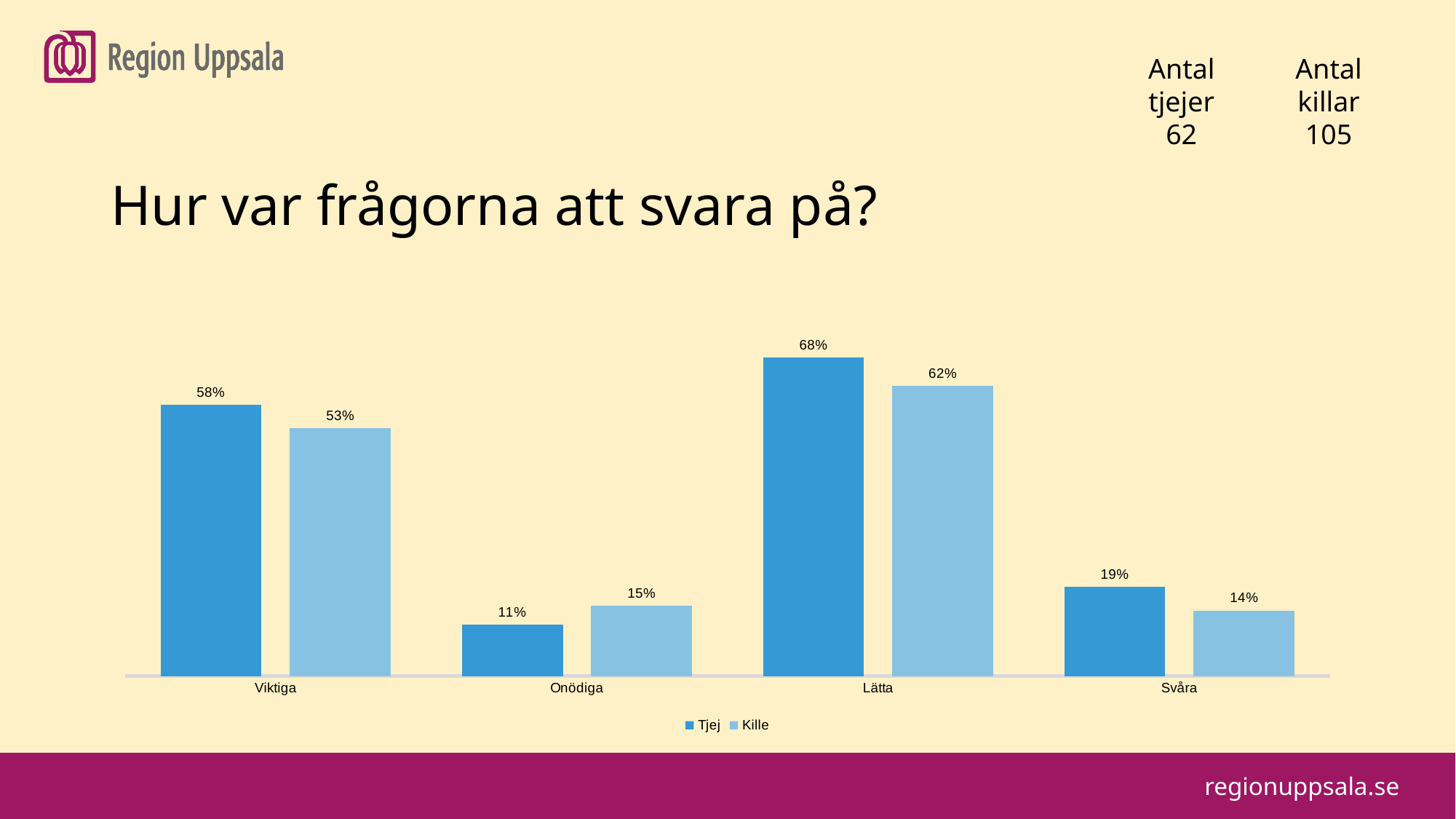
What kind of chart is shown on the slide? Bar chart What are the two series named in the legend? Tjej and Kille How many series does the legend list? 2 Which category has the lowest value for Kille? Svåra What is the value for Tjej in the Viktiga category? 58% What is the difference between the Tjej and Kille values in the Lätta category? 6% What is the value for Tjej in the Svåra category? 19% Which is larger in the Onödiga category, the Tjej value or the Kille value? Kille How many categories are shown on the x axis? 4 What is the value for Kille in the Onödiga category? 15% What is the value for Kille in the Lätta category? 62% Which category has the highest value for Tjej? Lätta